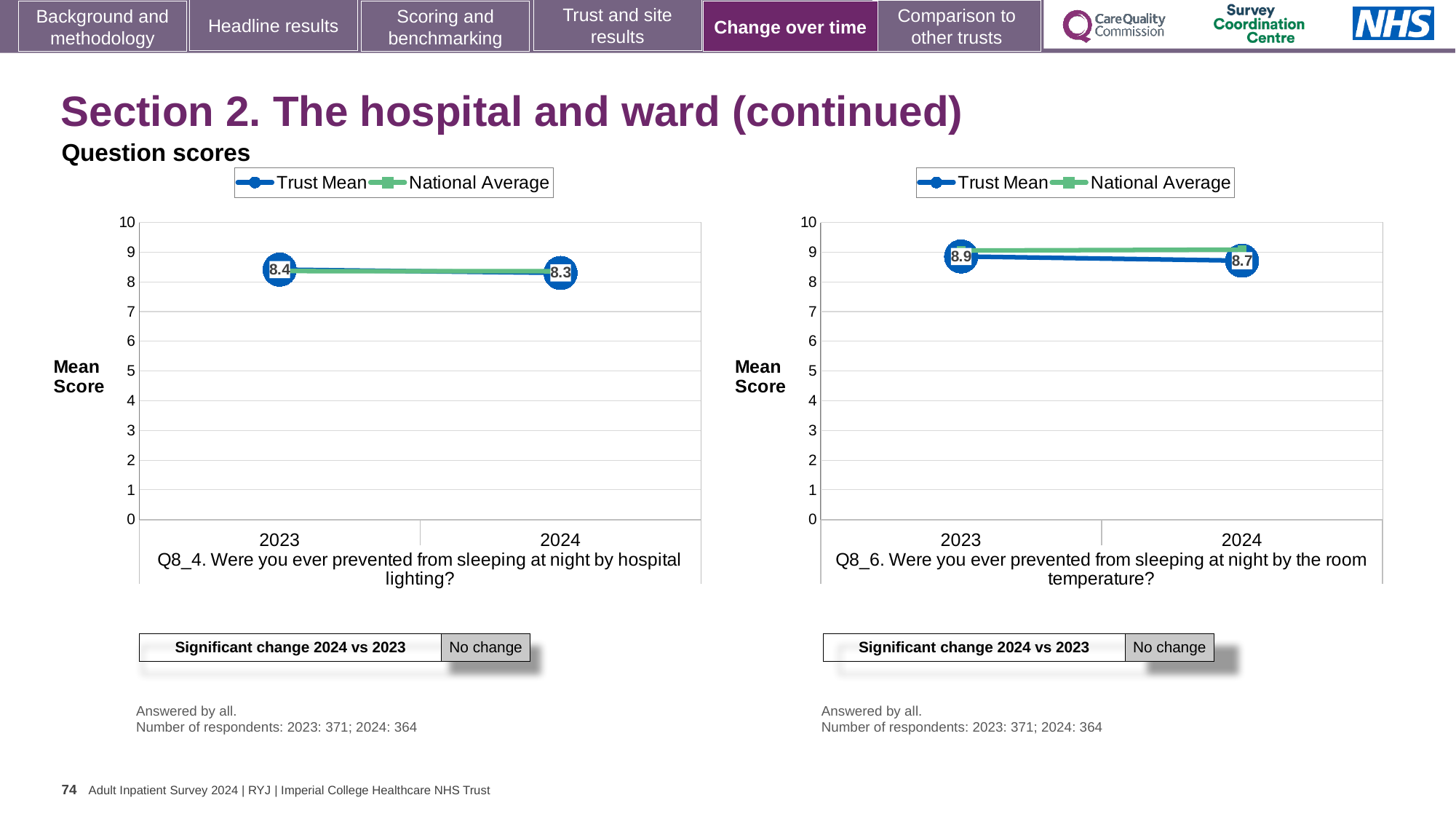
In the Q8_4 hospital lighting chart, what is the difference between the Trust Mean for 2023 and 2024? 0.1 In the Q8_4 hospital lighting chart, what is the Trust Mean for 2023? 8.4 How many series does the legend of the Q8_4 hospital lighting chart list? 2 In the Q8_4 hospital lighting chart, what is the Trust Mean for 2024? 8.3 In the Q8_6 room temperature chart, what is the difference between the Trust Mean for 2023 and 2024? 0.2 In the Q8_4 hospital lighting chart, is the Trust Mean for 2024 greater or less than 5? greater Which is larger: the 2023 Trust Mean in the Q8_4 hospital lighting chart or the 2023 Trust Mean in the Q8_6 room temperature chart? Q8_6 room temperature (8.9) In the Q8_6 room temperature chart, does the Trust Mean rise or fall from 2023 to 2024? fall In the Q8_6 room temperature chart, what is the Trust Mean for 2023? 8.9 What kind of chart is the Q8_4 hospital lighting chart? line chart In the Q8_6 room temperature chart, what is the Trust Mean for 2024? 8.7 How many years are plotted on the x axis of the Q8_6 room temperature chart? 2